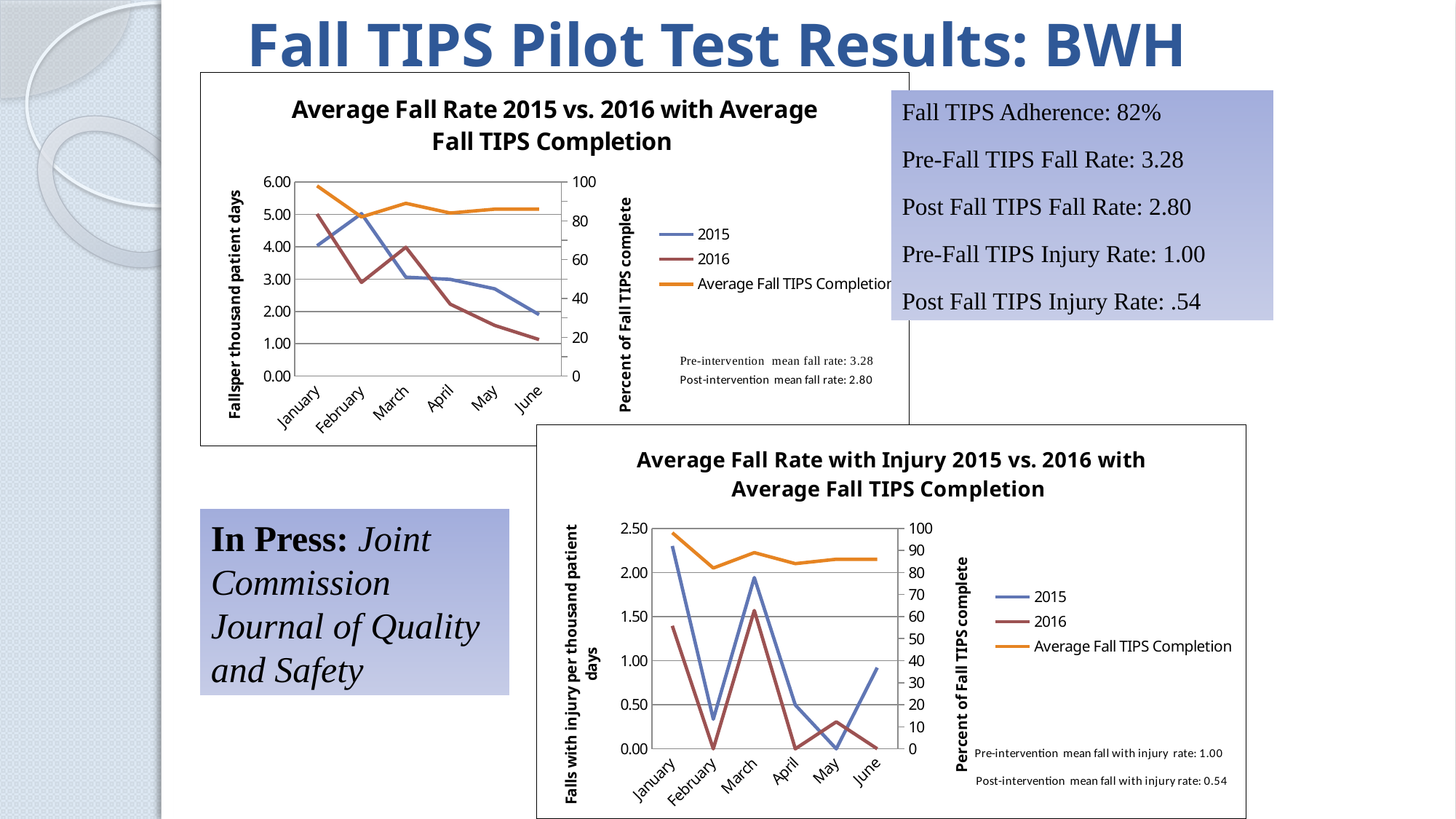
In the top chart, which is larger in March: the 2015 value or the 2016 value? 2016 What kind of chart is the top chart titled "Average Fall Rate 2015 vs. 2016 with Average Fall TIPS Completion"? line chart In the bottom chart, is the Average Fall TIPS Completion value for January greater or less than 90? greater How many series does the legend of the top chart list? 3 In the bottom chart, what is the 2015 value for May? 0.00 In the top chart, does the 2016 line generally rise or fall from January to June? fall In the top chart, is the 2015 value for February greater or less than 4.00? greater In the bottom chart, which month has the highest 2015 falls with injury rate? January In the top chart, which month has the highest 2016 fall rate? January In the top chart, is the 2016 value for June greater or less than 2.00? less How many months are plotted along the x axis of the bottom chart? 6 In the top chart, which month has the lowest 2015 fall rate? June